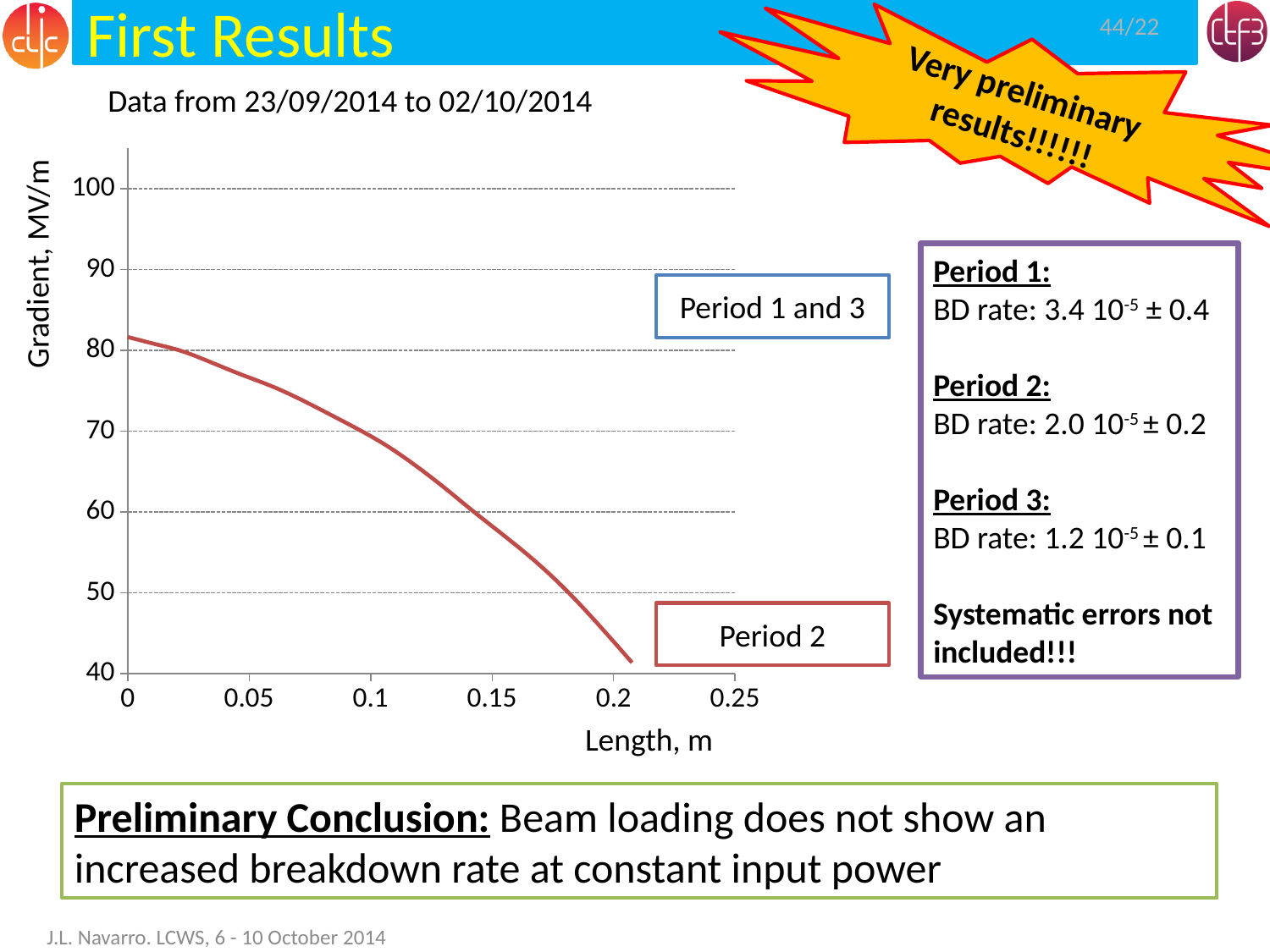
Is the gradient at a length of 0.2 m greater or less than 50 MV/m? greater Is the gradient at a length of 0.2 m greater or less than 40 MV/m? greater Is the gradient at a length of 0.05 m greater or less than 80 MV/m? less What kind of chart is shown on the slide? line chart What is the label of the x axis? Length, m Which has the larger gradient: length 0.05 m or length 0.2 m? 0.05 m How many lines (series) are plotted on the chart? 1 What is the label of the y axis? Gradient, MV/m Does the gradient rise or fall as length increases along the x axis? fall